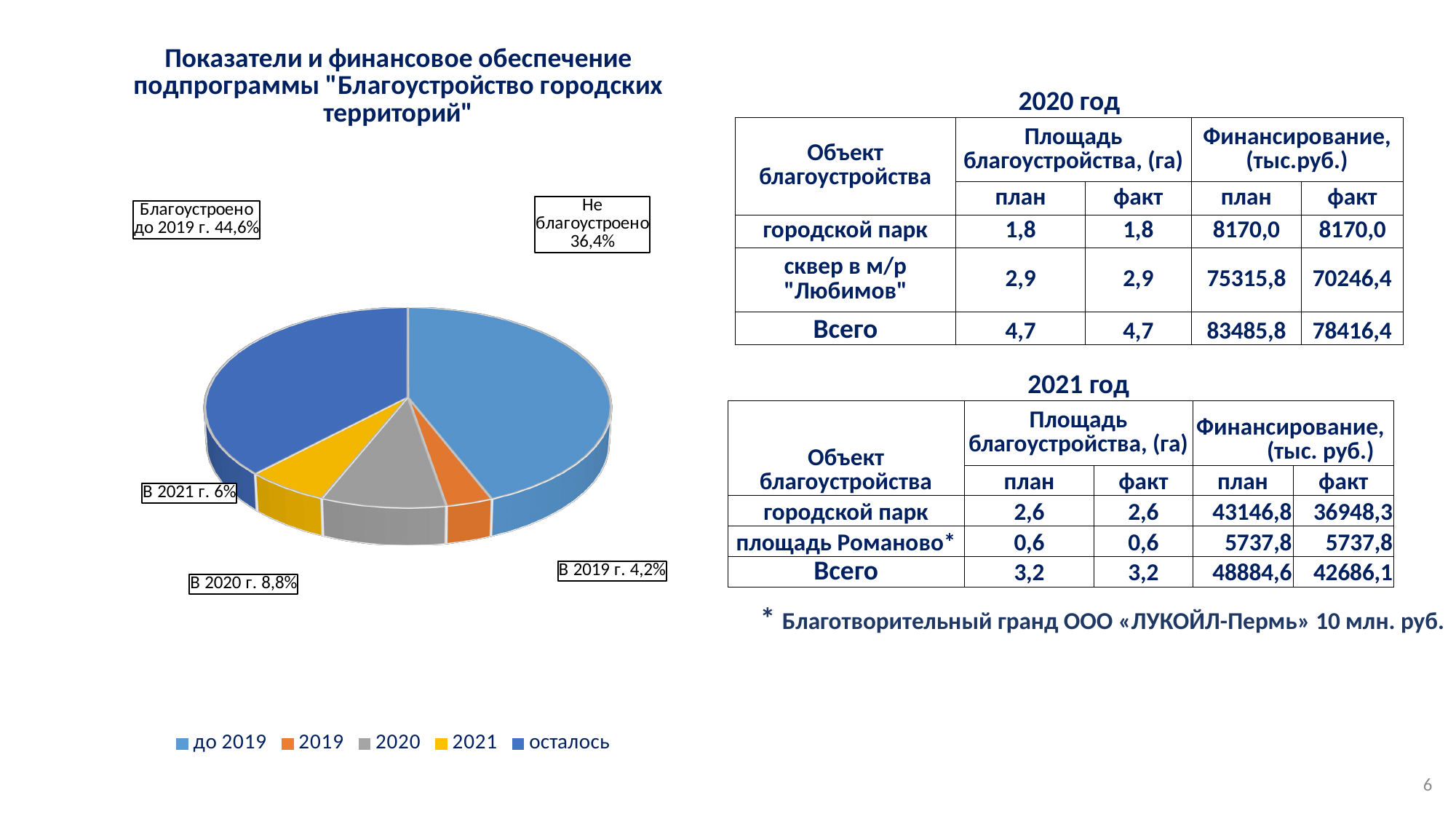
Which slice of the pie chart is the smallest? В 2019 г. Which is larger in the pie chart: the share for 2020 or the share for 2021? 2020 Which legend entry of the pie chart is shown in yellow? 2021 What is the difference between the "Благоустроено до 2019 г." share and the "Не благоустроено" share? 8,2% What share of the pie is labelled "В 2019 г."? 4,2% Which slice of the pie chart is the largest? Благоустроено до 2019 г. How many entries does the legend of the pie chart list? 5 What kind of chart is shown on the slide? pie chart What share of the pie is labelled "В 2021 г."? 6% What share of the pie is labelled "В 2020 г."? 8,8% What share of the pie is labelled "Не благоустроено"? 36,4% What share of the pie is labelled "Благоустроено до 2019 г."? 44,6%